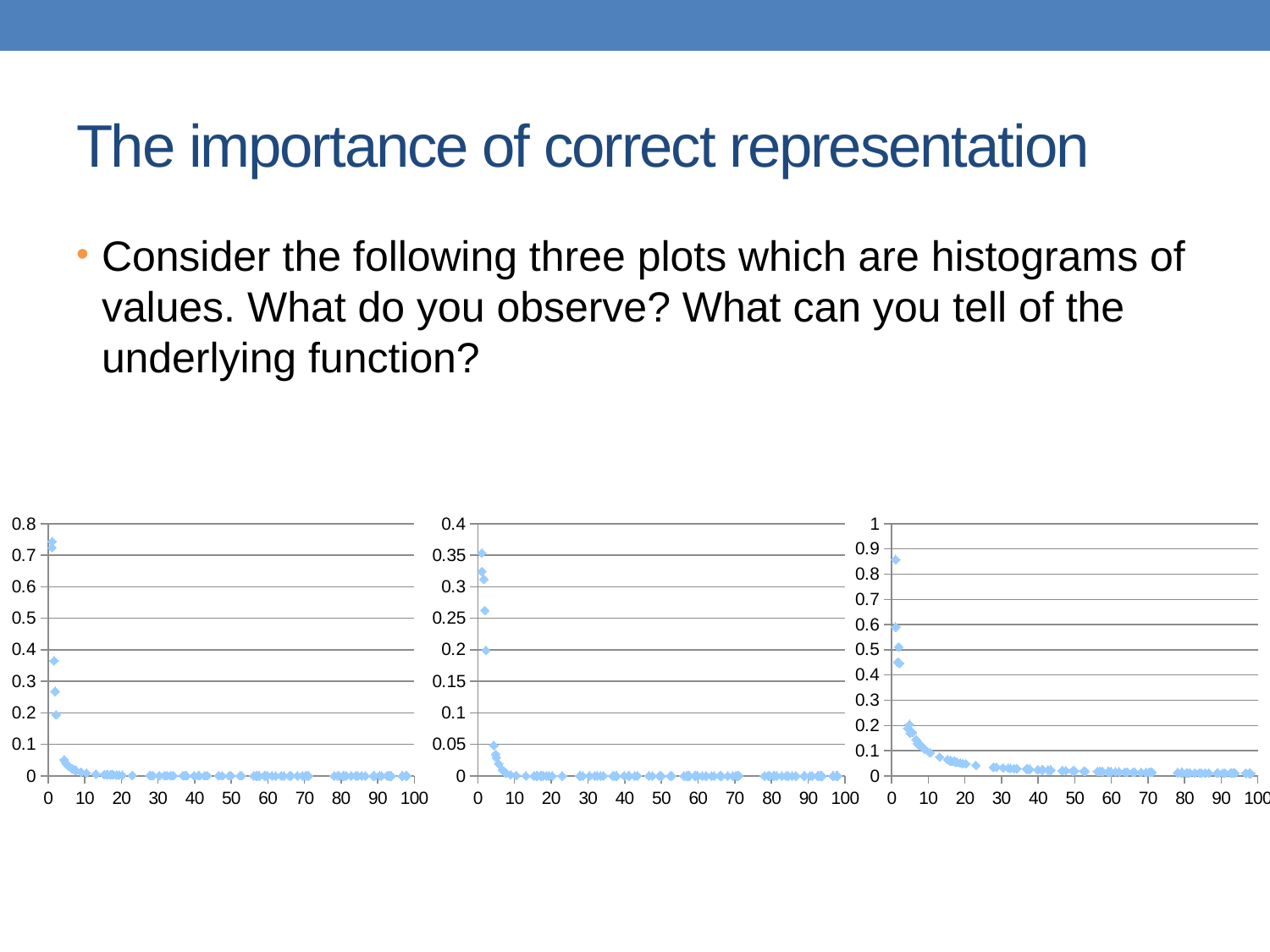
In the left chart, are the plotted values around x = 60 greater or less than 0.1? less In the left chart, is the highest plotted value greater or less than 0.7? greater In the left chart, do the plotted values rise or fall as x increases from 0 to 100? fall What is the maximum value shown on the y axis of the middle chart? 0.4 What kind of chart is the left chart on the slide? scatter chart Which chart has the higher maximum plotted value, the left chart or the right chart? the right chart How many charts are shown on the slide? 3 In the middle chart, is the highest plotted value greater or less than 0.3? greater In the right chart, do the plotted values rise or fall as x increases? fall In the middle chart, do the plotted values rise or fall as x increases? fall